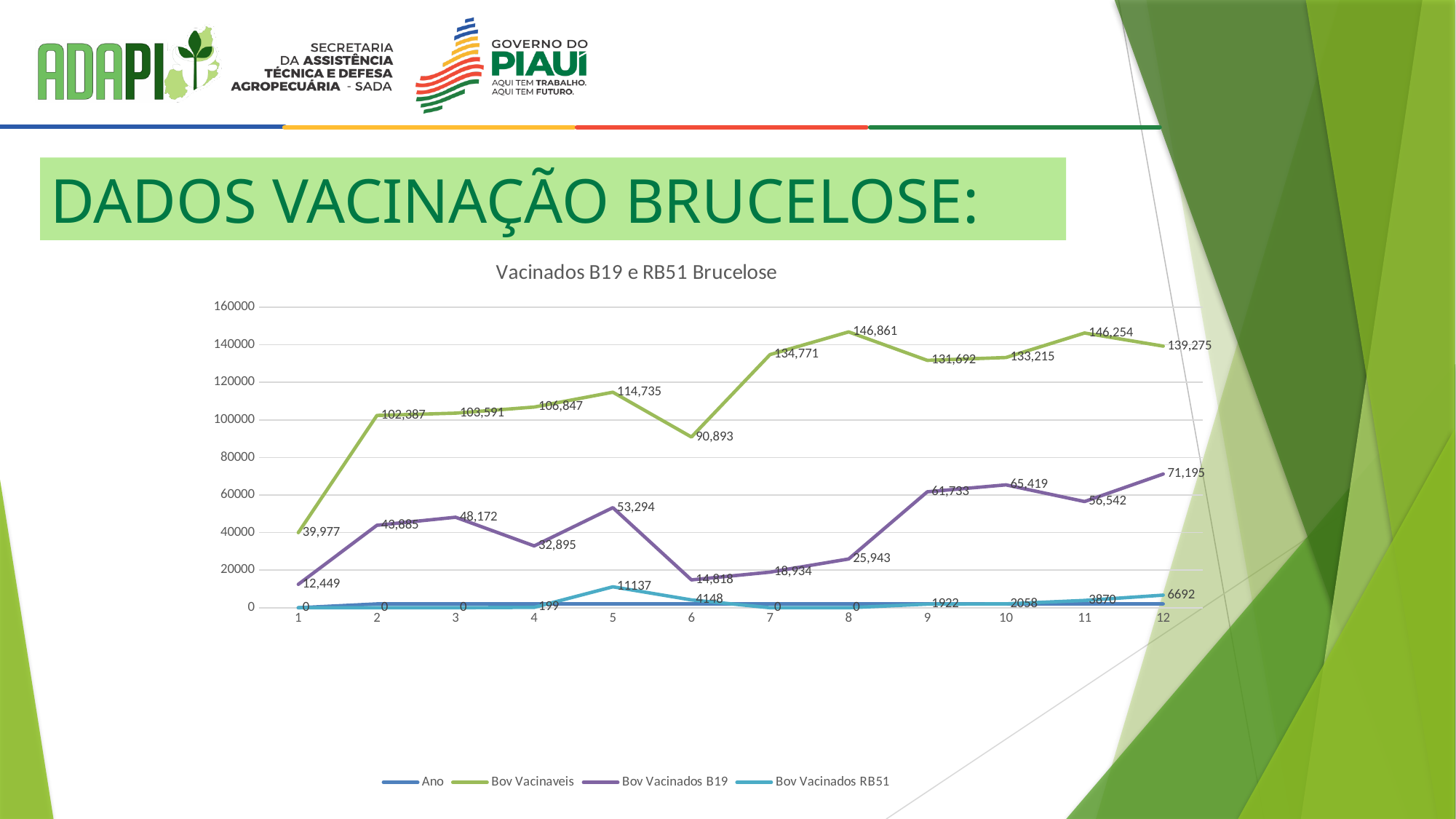
How many series does the legend list? 4 What is the value of Bov Vacinados B19 at point 12? 71,195 Which is larger: Bov Vacinados B19 at point 5 or Bov Vacinados B19 at point 4? Bov Vacinados B19 at point 5 What is the title of the chart? Vacinados B19 e RB51 Brucelose What type of chart is shown on the slide? line chart What is the value of Bov Vacinaveis at point 8? 146,861 How many points are plotted along the x axis for each series? 12 At which x-axis point is Bov Vacinaveis lowest? 1 What is the difference between Bov Vacinaveis and Bov Vacinados B19 at point 6? 76,075 What is the value of Bov Vacinados RB51 at point 5? 11137 At which x-axis point is Bov Vacinados B19 highest? 12 Is the value of Bov Vacinaveis at point 2 greater or less than 100000? greater